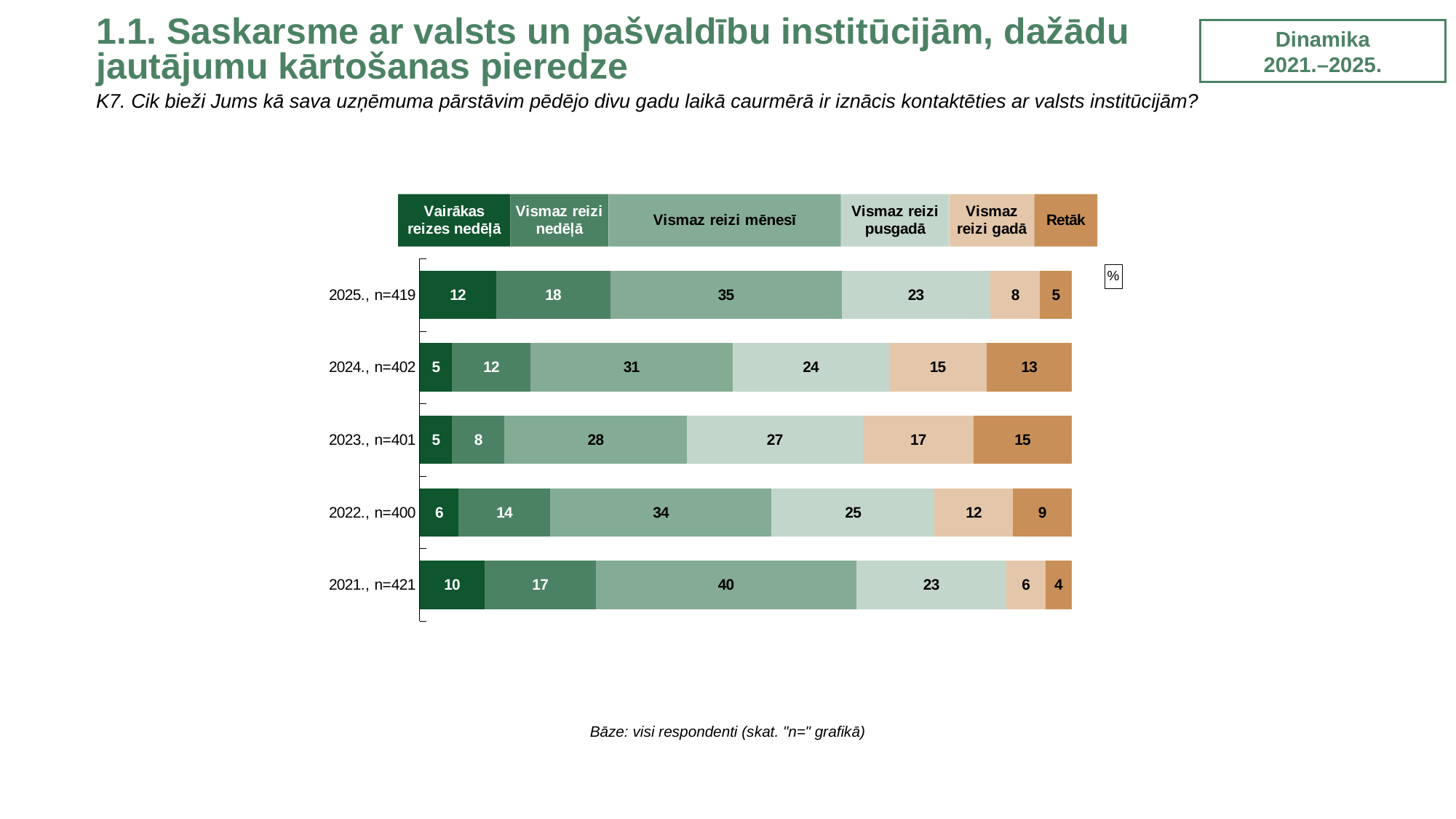
Which year has the lowest value for "Retāk"? 2021 What is the value for "Vismaz reizi gadā" in the 2024 bar? 15 Which year has the highest value for "Vismaz reizi mēnesī"? 2021 How many years (bars) are shown in the chart? 5 What is the total of the 2022 stacked bar? 100 What is the difference between the "Vismaz reizi nedēļā" values for 2025 and 2024? 6 What is the value for "Vismaz reizi mēnesī" in the 2025 bar? 35 Which year has the larger value for "Vismaz reizi pusgadā", 2023 or 2022? 2023 What kind of chart is shown on the slide? Stacked bar chart How many series does the legend list? 6 What is the value for "Retāk" in the 2023 bar? 15 What is the sample size (n) shown for the 2025 bar? n=419